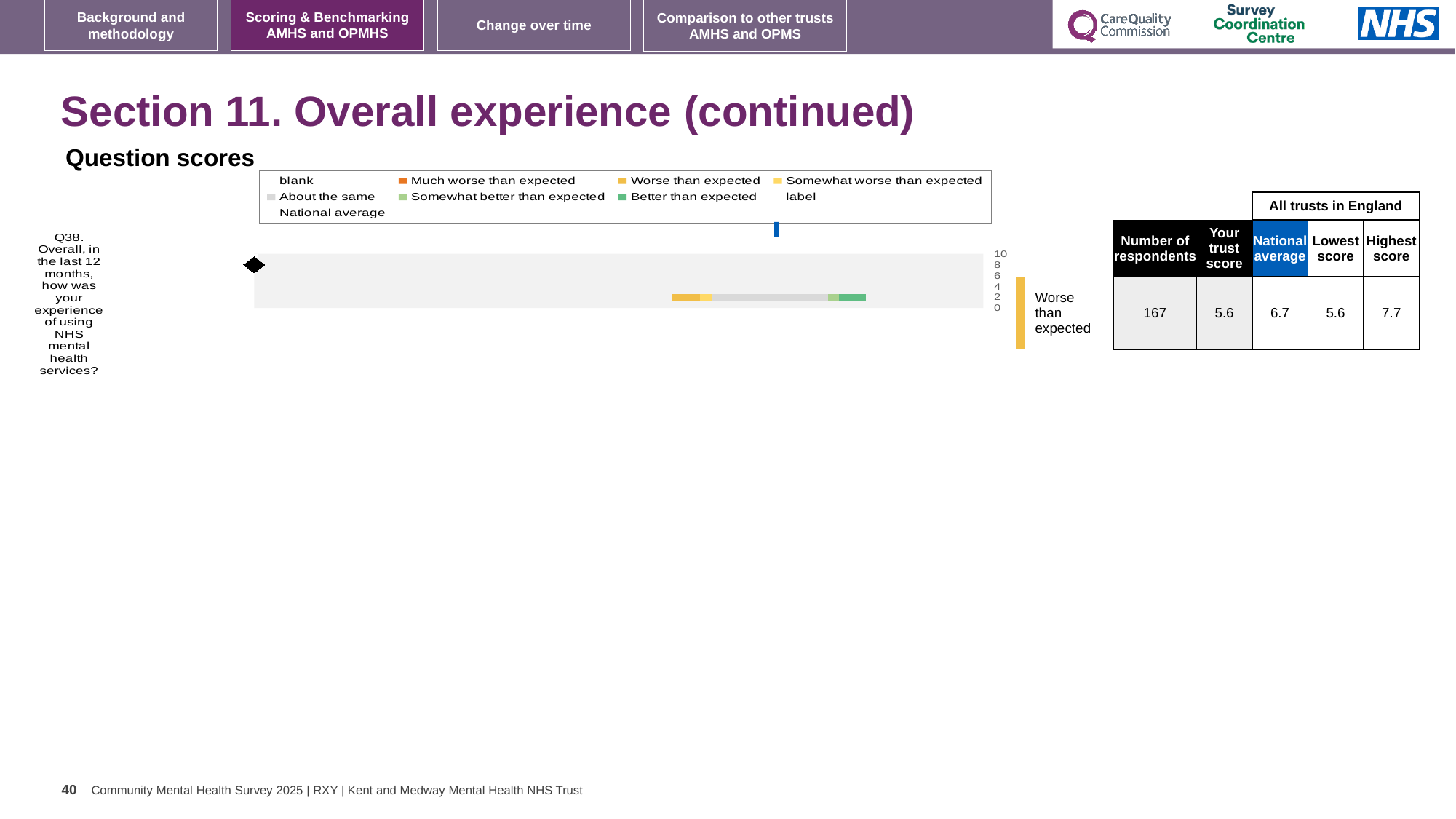
Which question is plotted in the 'Question scores' chart? Q38. Overall, in the last 12 months, how was your experience of using NHS mental health services? What is the highest score among all trusts in England for Q38? 7.7 Which benchmark category is the trust's Q38 score labelled as on the chart? Worse than expected Which is larger for Q38, the trust's score or the national average? national average What is the difference between the national average and the trust's score for Q38? 1.1 How many questions are plotted in the 'Question scores' chart? 1 What is the number of respondents for Q38? 167 What is the difference between the highest and lowest scores among all trusts in England for Q38? 2.1 What is the national average score for Q38? 6.7 What is the trust's score for Q38? 5.6 What is the lowest score among all trusts in England for Q38? 5.6 What kind of chart is shown under 'Question scores'? bar chart